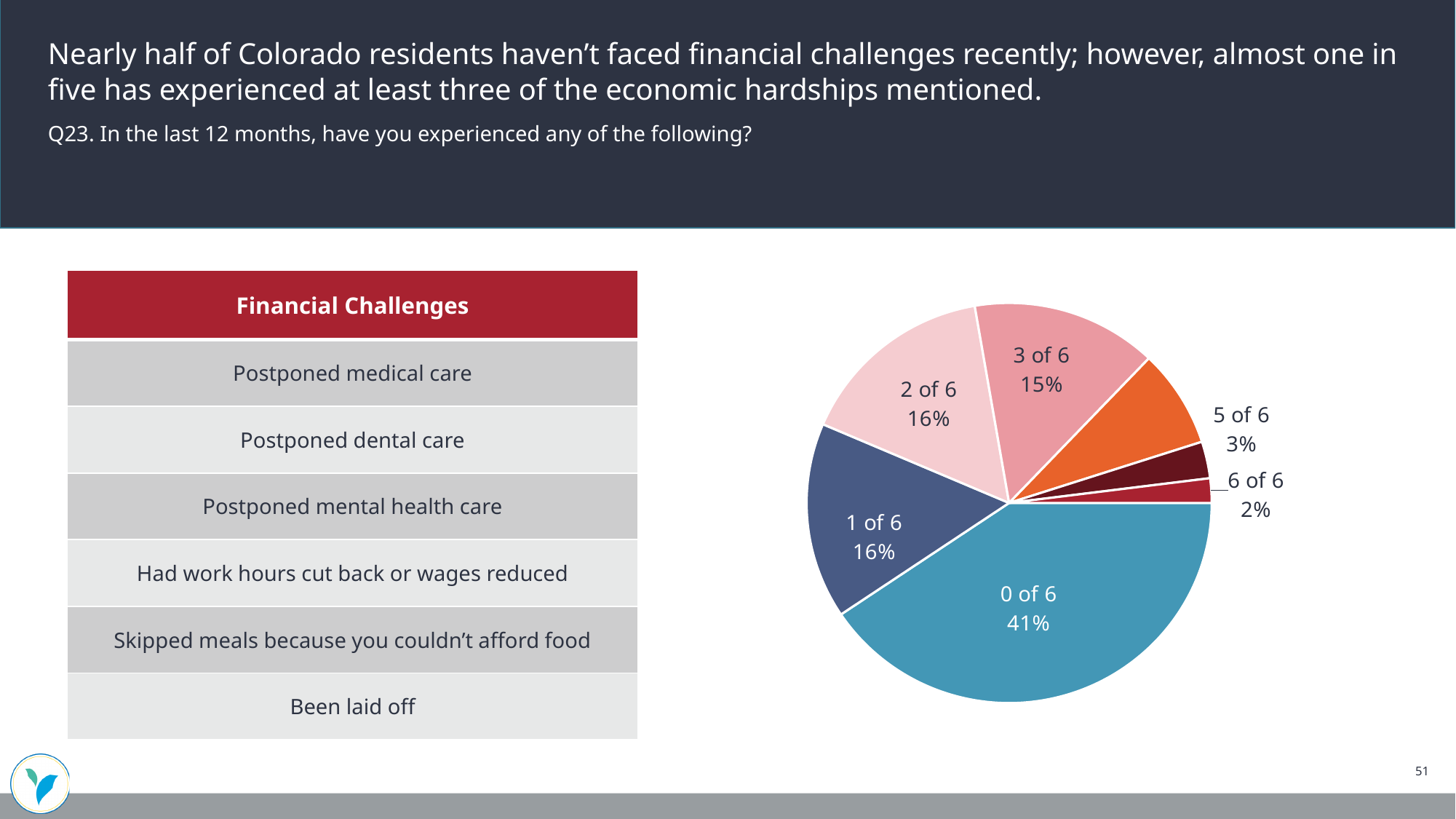
Which slice is larger, "3 of 6" or "5 of 6"? 3 of 6 Which labeled slice of the pie is the smallest? 6 of 6 What kind of chart is shown on the slide? Pie chart What percentage is shown for the "6 of 6" slice? 2% What share of the pie is labeled "0 of 6"? 41% What is the heading of the table to the left of the pie chart? Financial Challenges What percentage is shown for the "5 of 6" slice? 3% What is the difference in percentage points between the "0 of 6" slice and the "3 of 6" slice? 26 percentage points What percentage is shown for the "1 of 6" slice? 16% What percentage is shown for the "3 of 6" slice? 15% Which labeled slice of the pie is the largest? 0 of 6 What is the combined percentage of the "5 of 6" and "6 of 6" slices? 5%